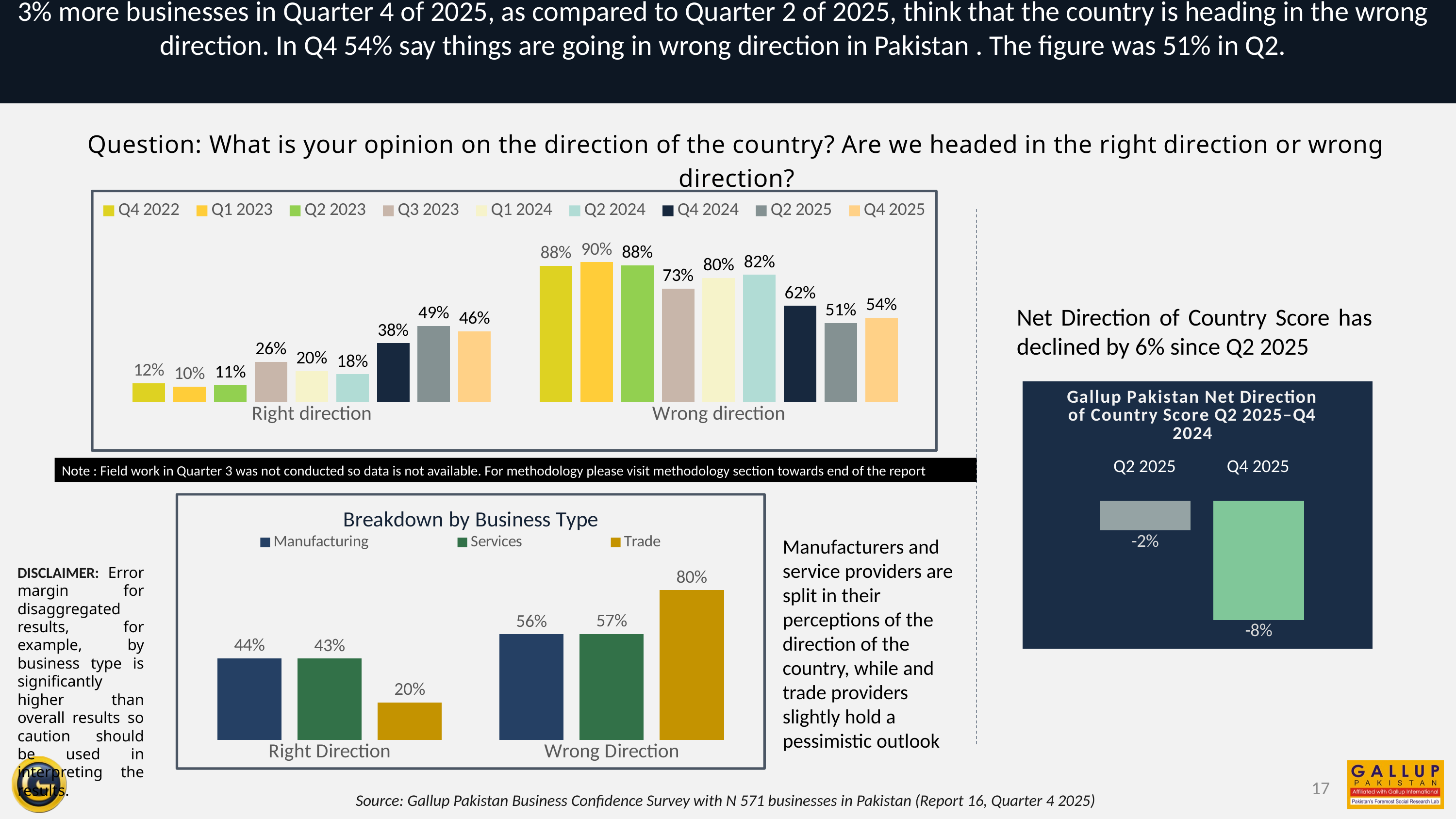
In the top-left chart of direction of the country by quarter, what is the value for Q2 2025 under Right direction? 49% How many series does the legend of the top-left chart of direction of the country by quarter list? 9 In the Gallup Pakistan Net Direction of Country Score chart, what is the value for Q4 2025? -8% In the top-left chart of direction of the country by quarter, which quarter has the lowest Right direction value? Q1 2023 What kind of chart is the Breakdown by Business Type chart? Bar chart In the Breakdown by Business Type chart, which business type has the lowest Right Direction value? Trade In the top-left chart of direction of the country by quarter, what is the difference between the Wrong direction values for Q4 2025 and Q2 2025? 3% In the top-left chart of direction of the country by quarter, which quarter has the highest Wrong direction value? Q1 2023 In the Breakdown by Business Type chart, what is the Trade value for Wrong Direction? 80% In the Gallup Pakistan Net Direction of Country Score chart, which quarter has the higher value, Q2 2025 or Q4 2025? Q2 2025 In the Breakdown by Business Type chart, what is the difference between the Manufacturing values for Wrong Direction and Right Direction? 12% In the top-left chart of direction of the country by quarter, what is the value for Q4 2025 under Wrong direction? 54%